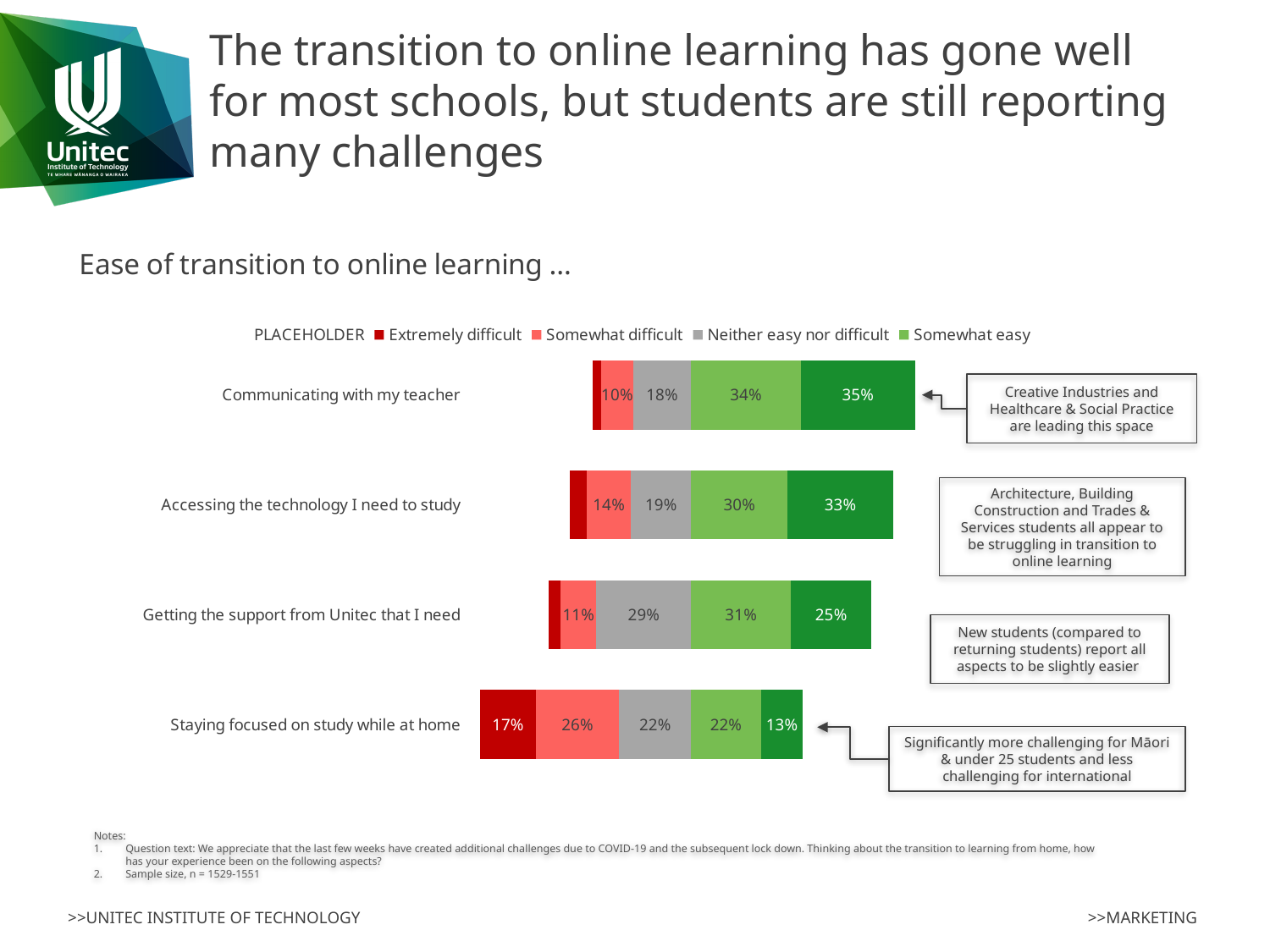
What is the title of the chart? Ease of transition to online learning … What is the 'Somewhat difficult' value for 'Staying focused on study while at home'? 26% What percentage of students found 'Communicating with my teacher' somewhat easy? 34% What value is shown in the dark green segment for 'Accessing the technology I need to study'? 33% Which category has the highest 'Somewhat difficult' value? Staying focused on study while at home What is the difference between the 'Neither easy nor difficult' values for 'Getting the support from Unitec that I need' and 'Communicating with my teacher'? 11 percentage points What is the 'Extremely difficult' value for 'Staying focused on study while at home'? 17% What type of chart is shown on the slide? Stacked bar chart What is the 'Neither easy nor difficult' value for 'Getting the support from Unitec that I need'? 29% Which category has the lowest 'Somewhat easy' value? Staying focused on study while at home Which has the larger 'Somewhat difficult' value: 'Accessing the technology I need to study' or 'Getting the support from Unitec that I need'? Accessing the technology I need to study How many categories are shown in the chart? 4